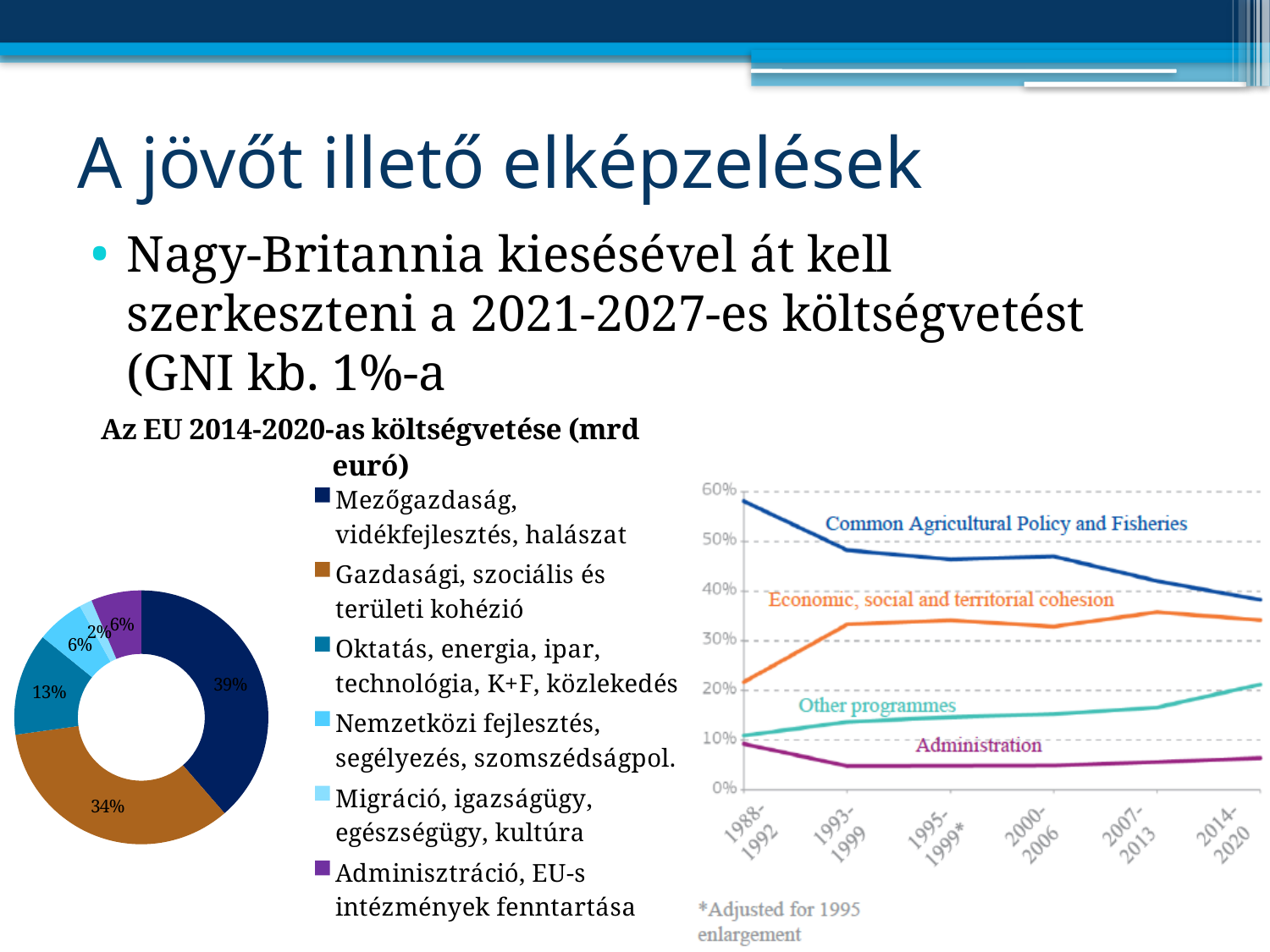
On the doughnut chart 'Az EU 2014-2020-as költségvetése (mrd euró)', what share is shown for Mezőgazdaság, vidékfejlesztés, halászat? 39% On the doughnut chart 'Az EU 2014-2020-as költségvetése (mrd euró)', which category has the largest share? Mezőgazdaság, vidékfejlesztés, halászat On the doughnut chart 'Az EU 2014-2020-as költségvetése (mrd euró)', what is the difference in percentage points between the Mezőgazdaság share and the Gazdasági, szociális és területi kohézió share? 5 percentage points On the line chart on the right, is the value for Common Agricultural Policy and Fisheries in 1988-1992 greater or less than 50%? greater On the doughnut chart 'Az EU 2014-2020-as költségvetése (mrd euró)', what share is shown for Gazdasági, szociális és területi kohézió? 34% On the line chart on the right, does the Common Agricultural Policy and Fisheries line rise or fall from 1988-1992 to 2014-2020? Fall On the doughnut chart 'Az EU 2014-2020-as költségvetése (mrd euró)', how many categories does the legend list? 6 On the doughnut chart 'Az EU 2014-2020-as költségvetése (mrd euró)', which is larger: the share for Oktatás, energia, ipar, technológia, K+F, közlekedés or the share for Adminisztráció, EU-s intézmények fenntartása? Oktatás, energia, ipar, technológia, K+F, közlekedés On the line chart on the right, how many budget periods are shown on the x axis? 6 What kind of chart is the chart on the right side of the slide? Line chart On the line chart on the right, how many series are plotted? 4 On the doughnut chart 'Az EU 2014-2020-as költségvetése (mrd euró)', which category has the smallest share? Migráció, igazságügy, egészségügy, kultúra